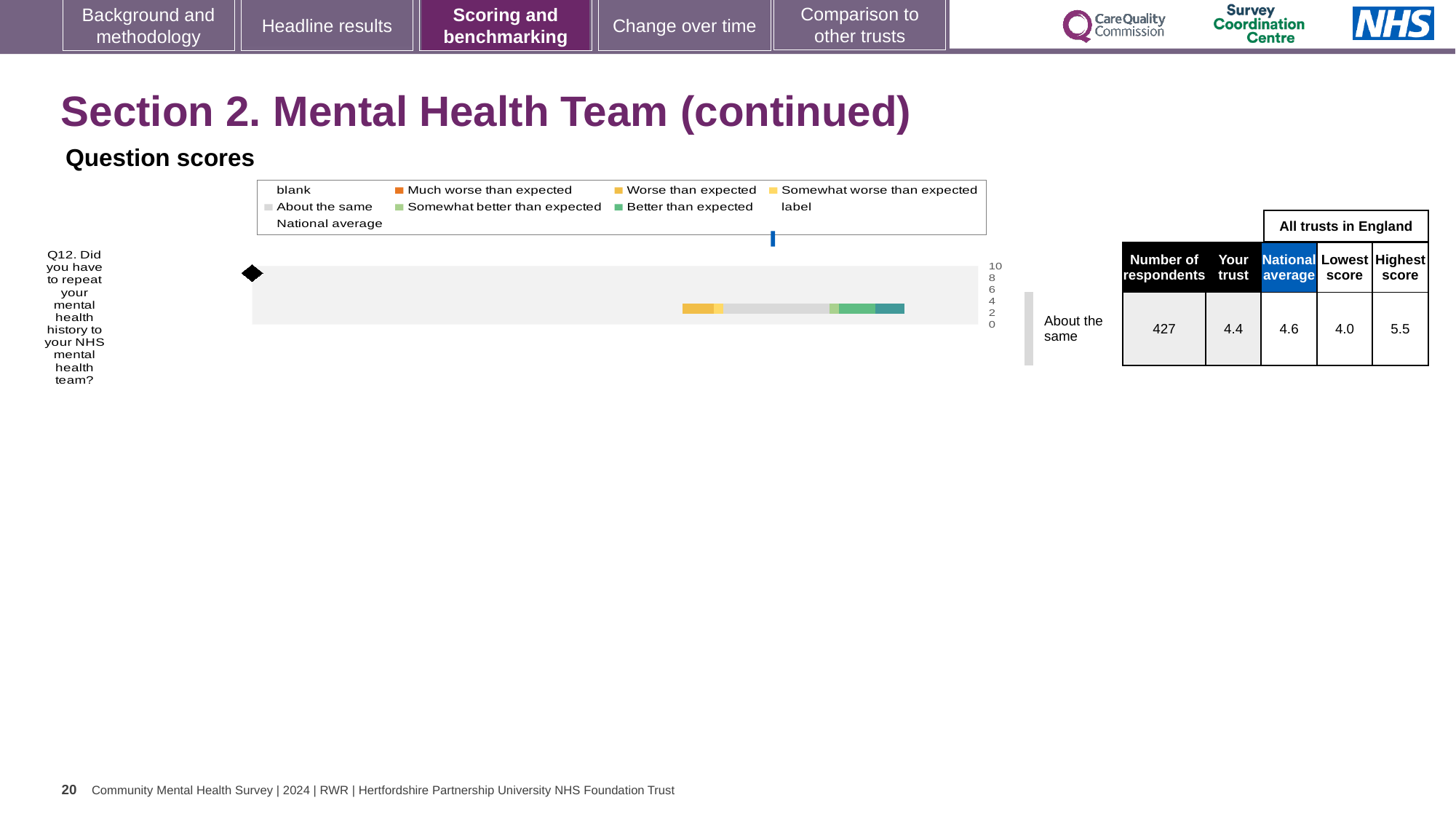
What is the 'Your trust' score for Q12? 4.4 What is the difference between the national average and the 'Your trust' score for Q12? 0.2 Which is larger for Q12, the 'Your trust' score or the national average? National average How many survey questions are plotted on the chart? 1 What is the lowest score among all trusts in England for Q12? 4.0 What type of chart is used to show the Q12 question score? bar chart What is the difference between the highest and lowest scores for Q12 across all trusts in England? 1.5 What benchmarking category label is shown next to the Q12 bar? About the same What is the highest score among all trusts in England for Q12? 5.5 Which question is plotted on the chart? Q12. Did you have to repeat your mental health history to your NHS mental health team? How many respondents answered Q12? 427 What is the national average score for Q12? 4.6